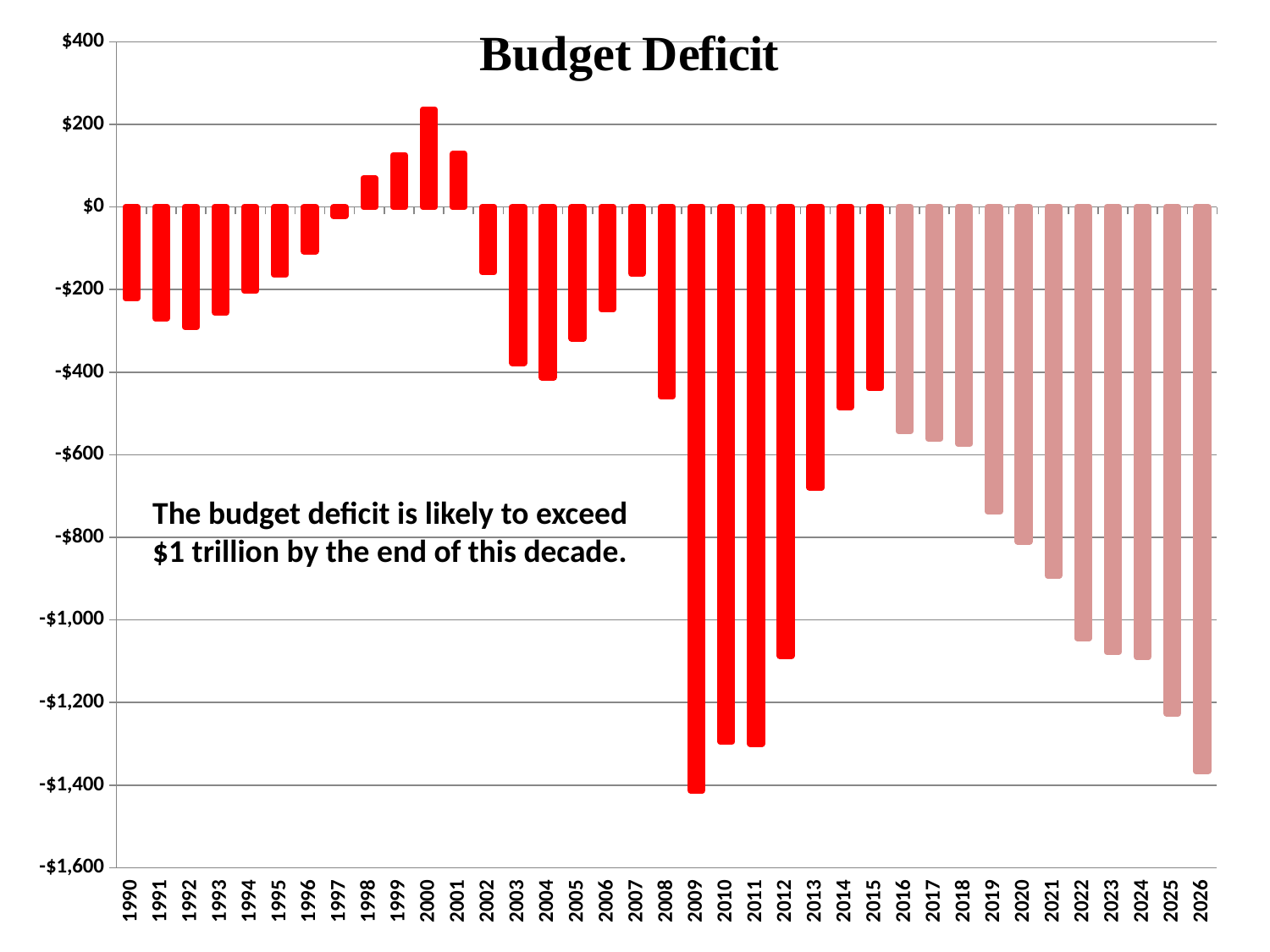
How many years are plotted on the x axis? 37 Is the value for 2000 greater or less than $200? greater Which year has the lowest value on the chart? 2009 Is the value for 2013 greater or less than -$800? greater What kind of chart is shown on the slide? bar chart What is the title of the chart? Budget Deficit Which year has the highest value on the chart? 2000 Do the values rise or fall from 2016 to 2026? fall Which year has the larger value, 1999 or 2000? 2000 Is the value for 2016 greater or less than -$400? less